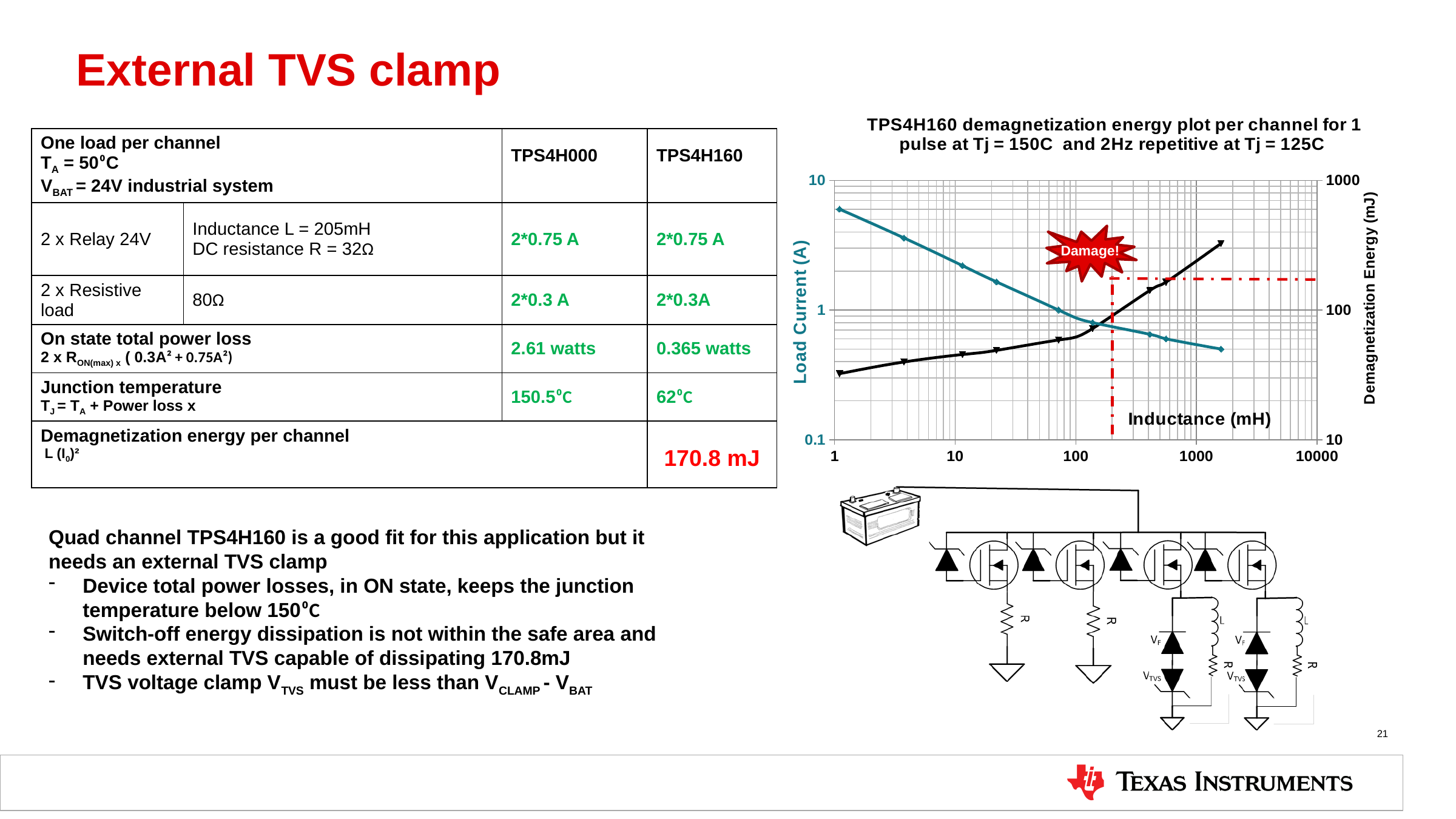
What is the highest value shown on the right-hand Demagnetization Energy axis? 1000 At an inductance of 1000 mH, is the Load Current value greater or less than 1 A? less Does the Demagnetization Energy line rise or fall as inductance increases along the x axis? rise At an inductance of 1000 mH, is the Demagnetization Energy value greater or less than 100 mJ? greater At an inductance of 1 mH, is the Demagnetization Energy value greater or less than 100 mJ? less How many lines are plotted on the chart? 2 What kind of chart is shown on the slide? line chart What is the title of the chart? TPS4H160 demagnetization energy plot per channel for 1 pulse at Tj = 150C and 2Hz repetitive at Tj = 125C What is the label of the x axis of the chart? Inductance (mH) Does the Load Current line rise or fall as inductance increases along the x axis? fall